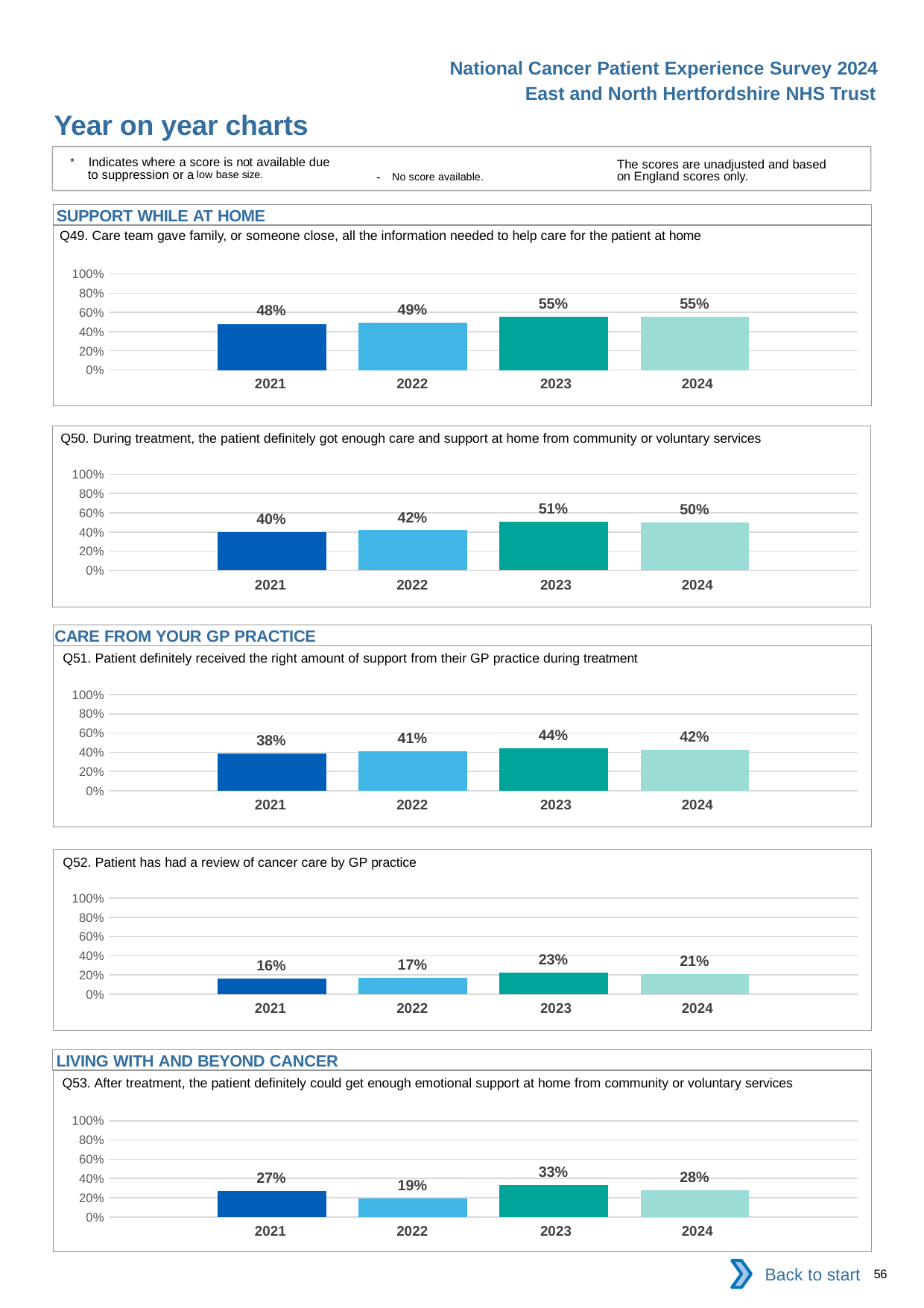
In the Q51 chart, what is the value for 2024? 42% In the Q51 chart, which year has the lowest value? 2021 In the Q53 chart, what is the value for 2023? 33% What kind of chart is the Q52 chart? bar chart In the Q49 chart, how many years are plotted? 4 In the Q53 chart, which is larger, the value for 2021 or the value for 2022? 2021 In the Q50 chart, what is the difference between the 2024 and 2021 values? 10% In the Q50 chart, which year has the highest value? 2023 In the Q49 chart, do the values rise or fall from 2021 to 2023? rise In the Q52 chart, what is the difference between the 2023 and 2021 values? 7% Which section heading appears above the Q53 chart? LIVING WITH AND BEYOND CANCER In the Q49 chart, what is the value for 2021? 48%